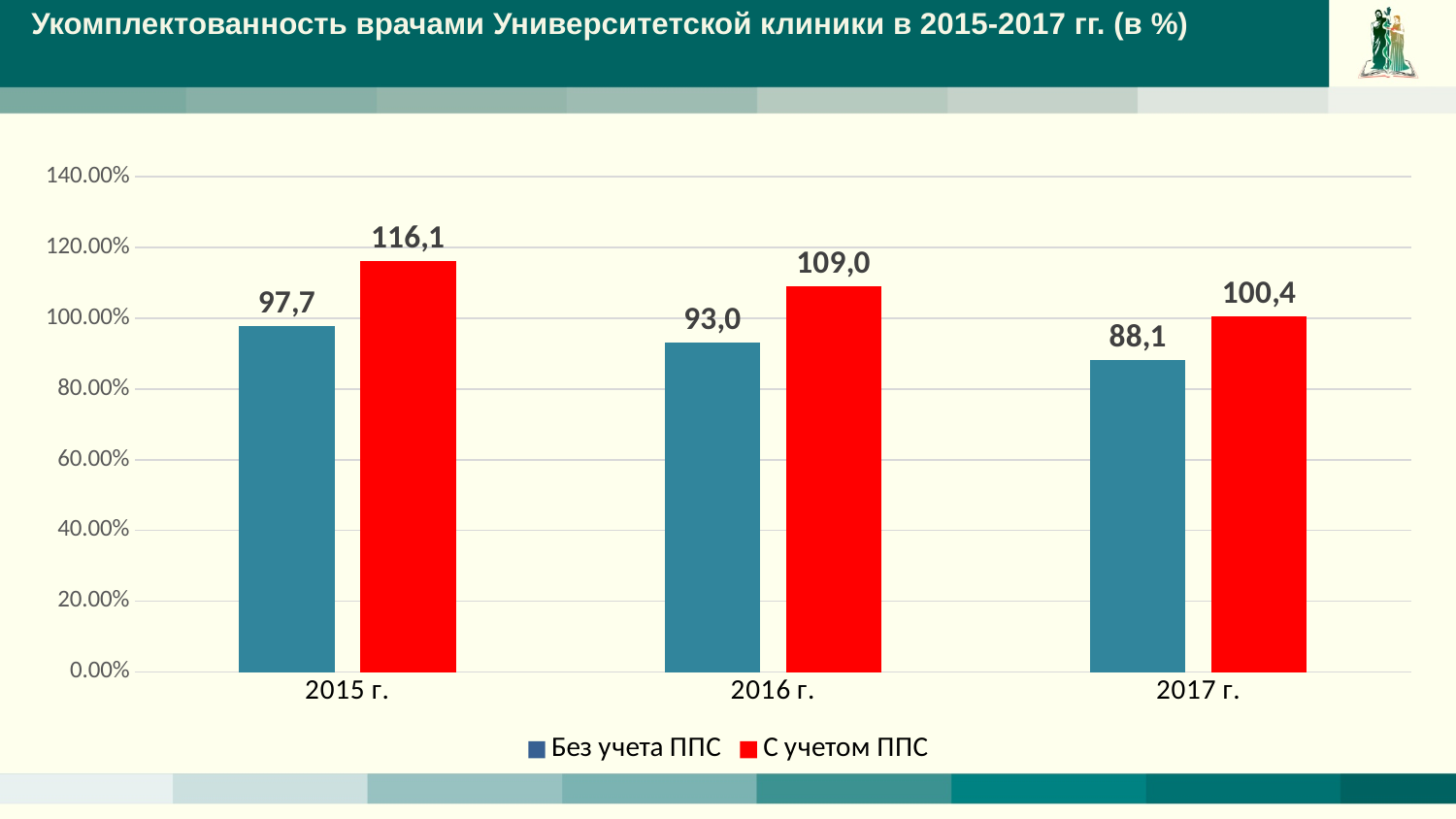
How many series does the legend list? 2 In which year is the value for "С учетом ППС" highest? 2015 г. What is the difference between "С учетом ППС" and "Без учета ППС" in 2015 г.? 18,4 Which is larger: "Без учета ППС" in 2015 г. or "С учетом ППС" in 2017 г.? С учетом ППС in 2017 г. Do the values for "Без учета ППС" rise or fall from 2015 г. to 2017 г.? Fall What is the difference between "С учетом ППС" and "Без учета ППС" in 2017 г.? 12,3 In which year is the value for "Без учета ППС" lowest? 2017 г. What is the value for "С учетом ППС" in 2016 г.? 109,0 What is the value for "С учетом ППС" in 2017 г.? 100,4 What is the value for "Без учета ППС" in 2015 г.? 97,7 What is the value for "Без учета ППС" in 2017 г.? 88,1 What kind of chart is shown on the slide? Bar chart